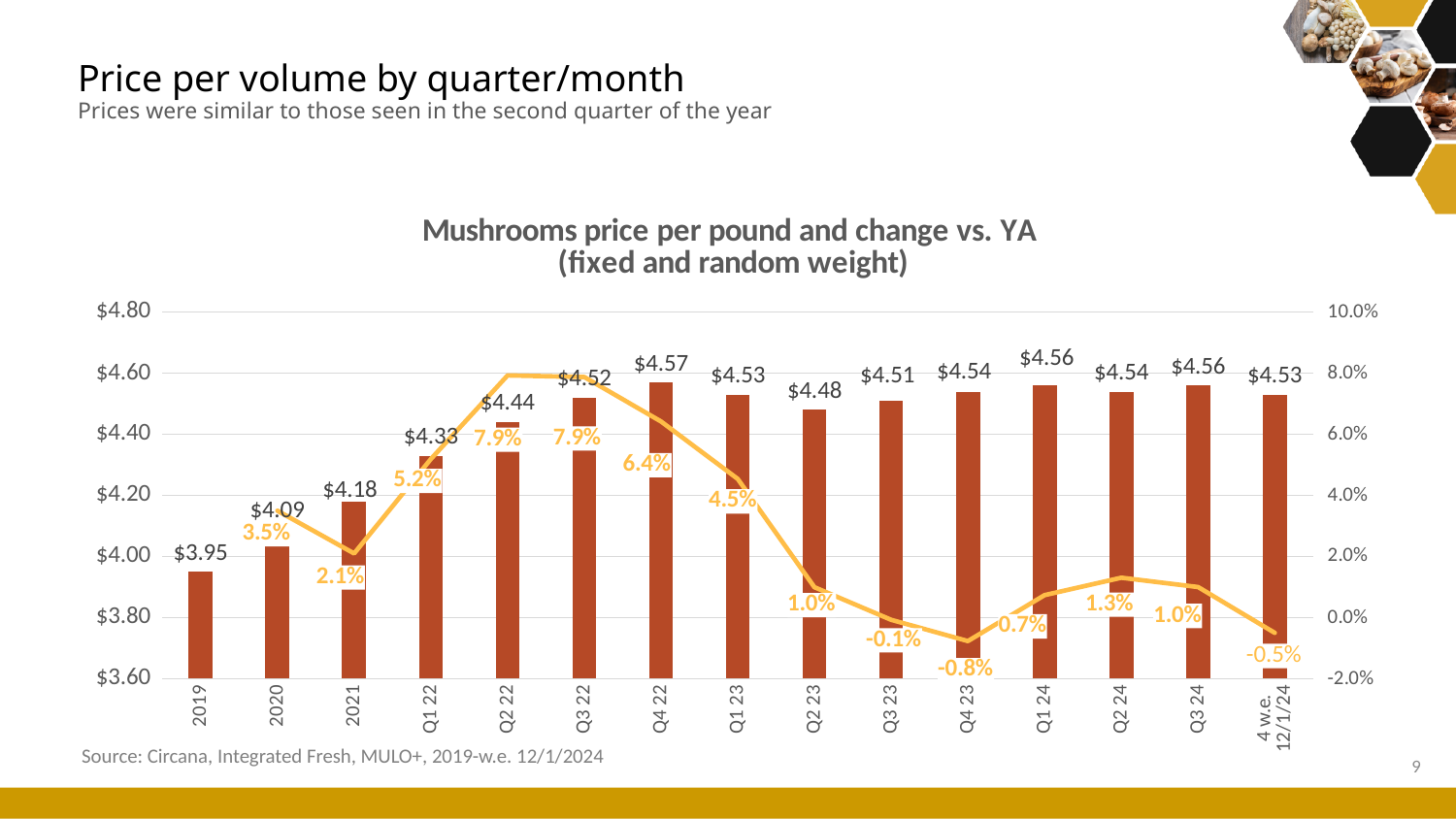
Does the price per pound rise or fall from 2019 to Q4 22? Rise How many periods are shown on the x axis? 15 What is the title of the chart? Mushrooms price per pound and change vs. YA (fixed and random weight) Which period has the lowest change vs. YA? Q4 23 What is the mushroom price per pound for Q4 22? $4.57 Which has the higher price per pound, Q1 24 or Q2 24? Q1 24 What is the difference in price per pound between Q4 22 and 2019? $0.62 What is the change vs. YA shown for Q2 24? 1.3% What kind of chart is this? Combination bar and line chart Which period has the lowest price per pound? 2019 What is the price per pound for the 4 w.e. 12/1/24 period? $4.53 Which period has the highest price per pound? Q4 22